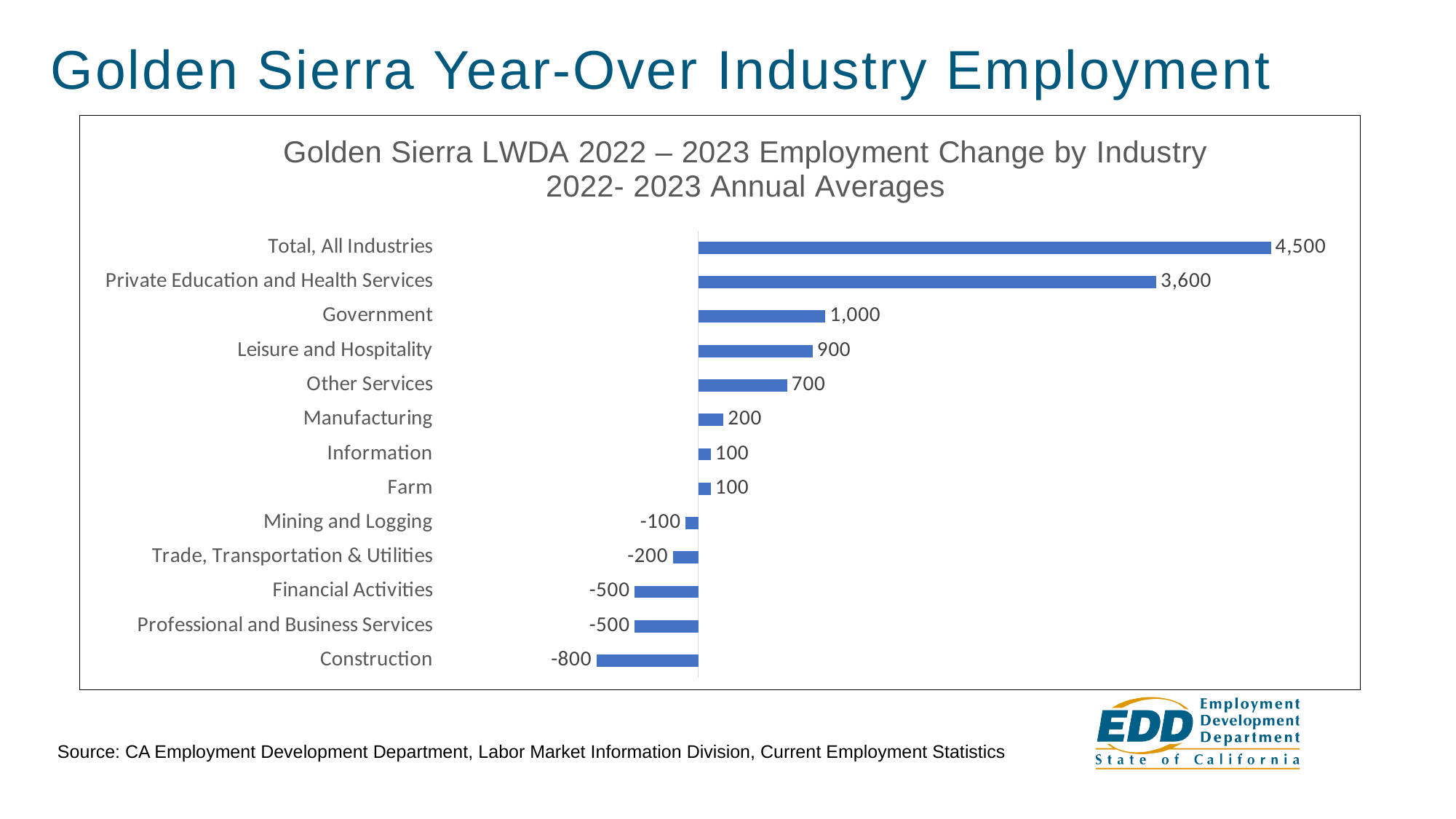
What is the title of the chart? Golden Sierra LWDA 2022 – 2023 Employment Change by Industry 2022- 2023 Annual Averages Which has a larger employment change, Manufacturing or Leisure and Hospitality? Leisure and Hospitality How many categories are shown in the chart? 13 What is the difference between the employment change for Total, All Industries and for Private Education and Health Services? 900 What is the employment change for Leisure and Hospitality? 900 What is the employment change for Construction? -800 What kind of chart is shown on the slide? Bar chart What is the employment change for Trade, Transportation & Utilities? -200 What is the difference between the employment change for Government and for Other Services? 300 What is the employment change for Private Education and Health Services? 3,600 Which category has the highest employment change? Total, All Industries Which industry has the lowest employment change? Construction